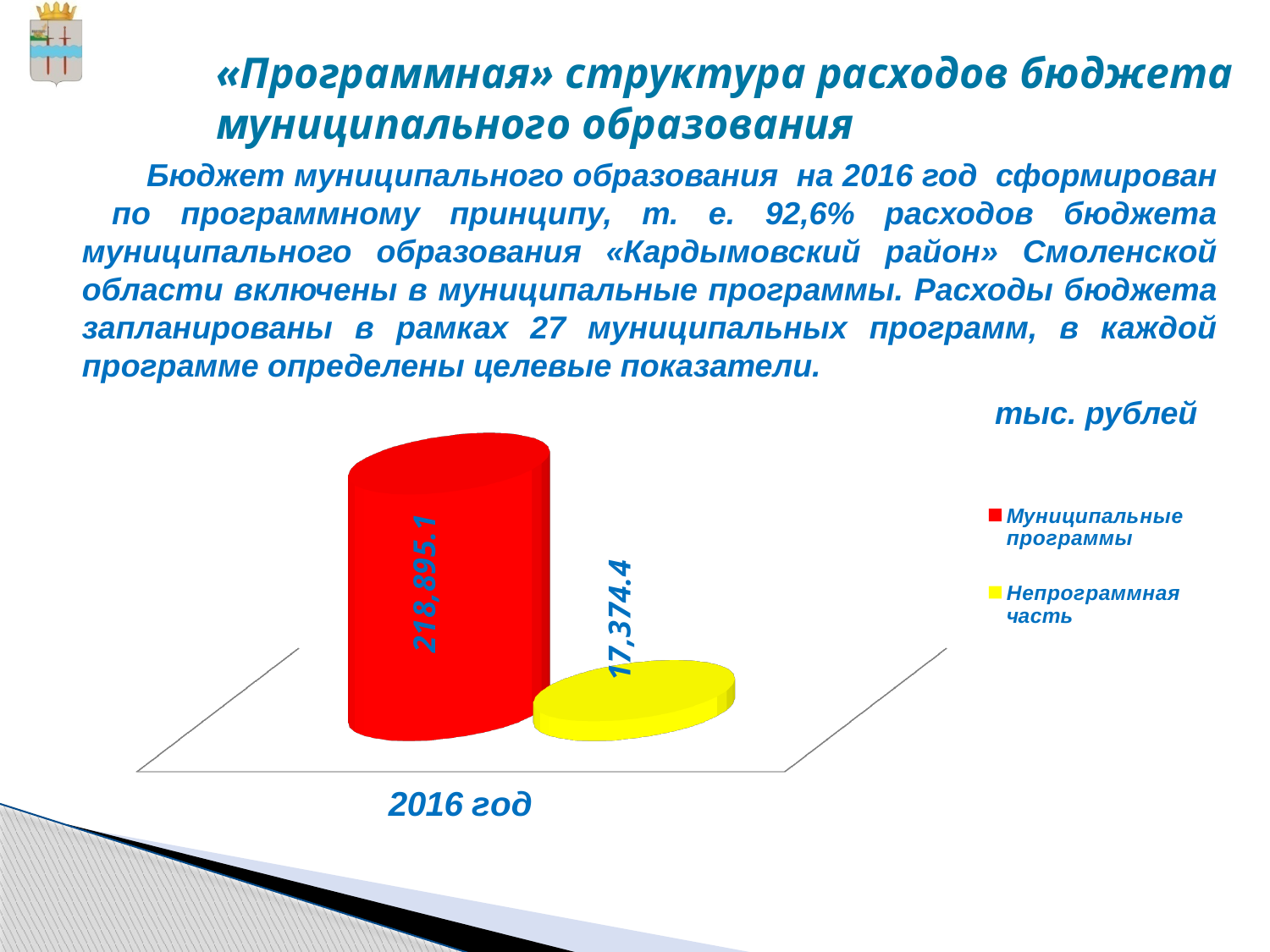
What is the combined value of Муниципальные программы and Непрограммная часть for 2016 год? 236,269.5 What unit is indicated for the chart values? тыс. рублей What is the value for Непрограммная часть in 2016 год? 17,374.4 What is the difference between the values for Муниципальные программы and Непрограммная часть? 201,520.7 What kind of chart is shown on the slide? bar chart What is the value for Муниципальные программы in 2016 год? 218,895.1 Which series has the lower value in 2016 год? Непрограммная часть What colour represents Непрограммная часть in the chart? yellow Is the value for Муниципальные программы larger or smaller than the value for Непрограммная часть? larger How many series does the legend list? 2 How many categories are shown on the x axis? 1 Which series has the higher value in 2016 год? Муниципальные программы